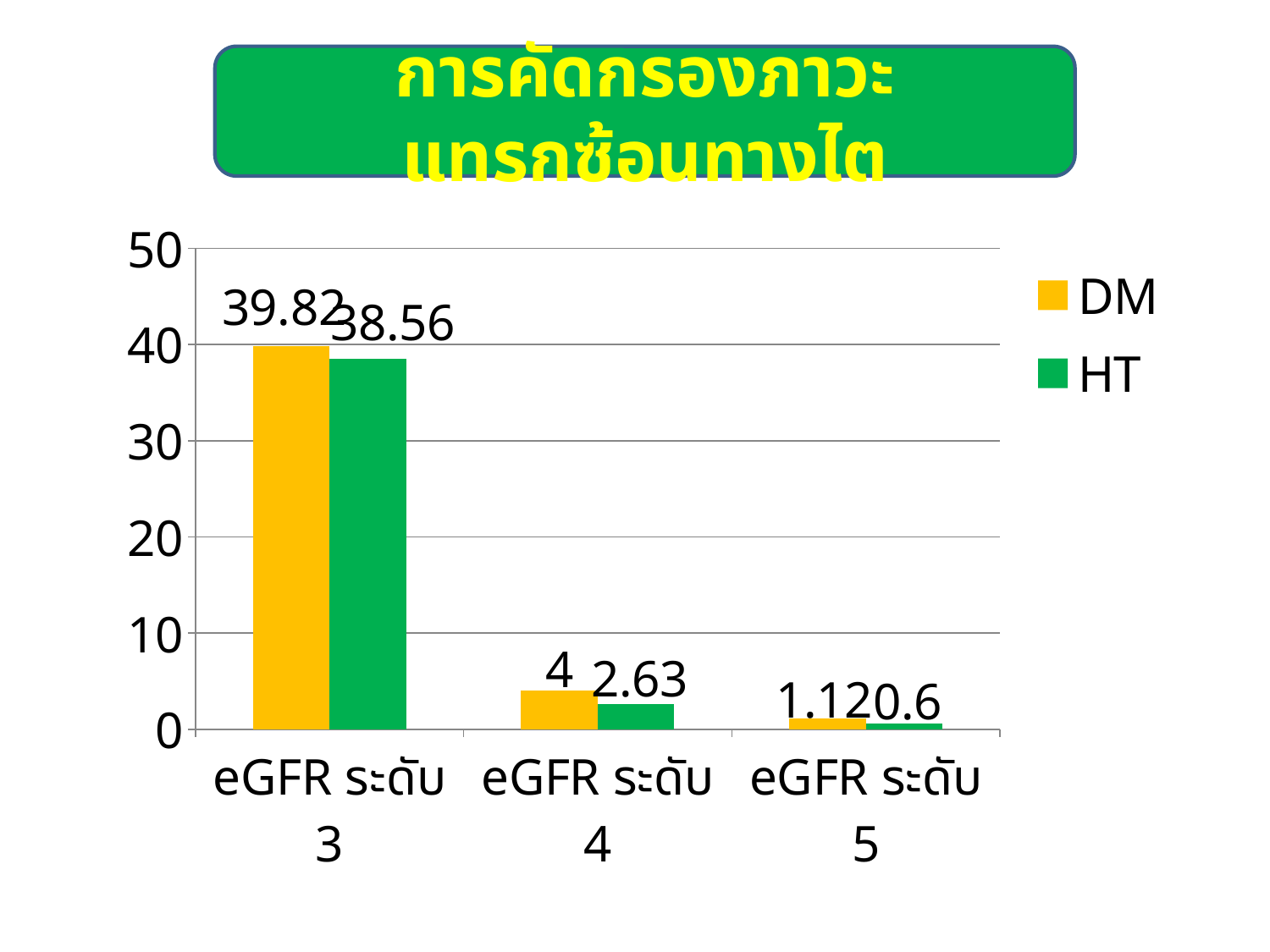
Which category has the highest HT value? eGFR ระดับ 3 What is the DM value for eGFR ระดับ 3? 39.82 What is the difference between the DM and HT values for eGFR ระดับ 4? 1.37 What is the HT value for eGFR ระดับ 4? 2.63 How many categories are shown on the x axis? 3 How many series does the legend list? 2 Do the DM values rise or fall from eGFR ระดับ 3 to eGFR ระดับ 5? fall Which is larger for eGFR ระดับ 3, the DM value or the HT value? DM What is the DM value for eGFR ระดับ 5? 1.12 What is the HT value for eGFR ระดับ 5? 0.6 Which category has the lowest DM value? eGFR ระดับ 5 What kind of chart is shown on the slide? bar chart